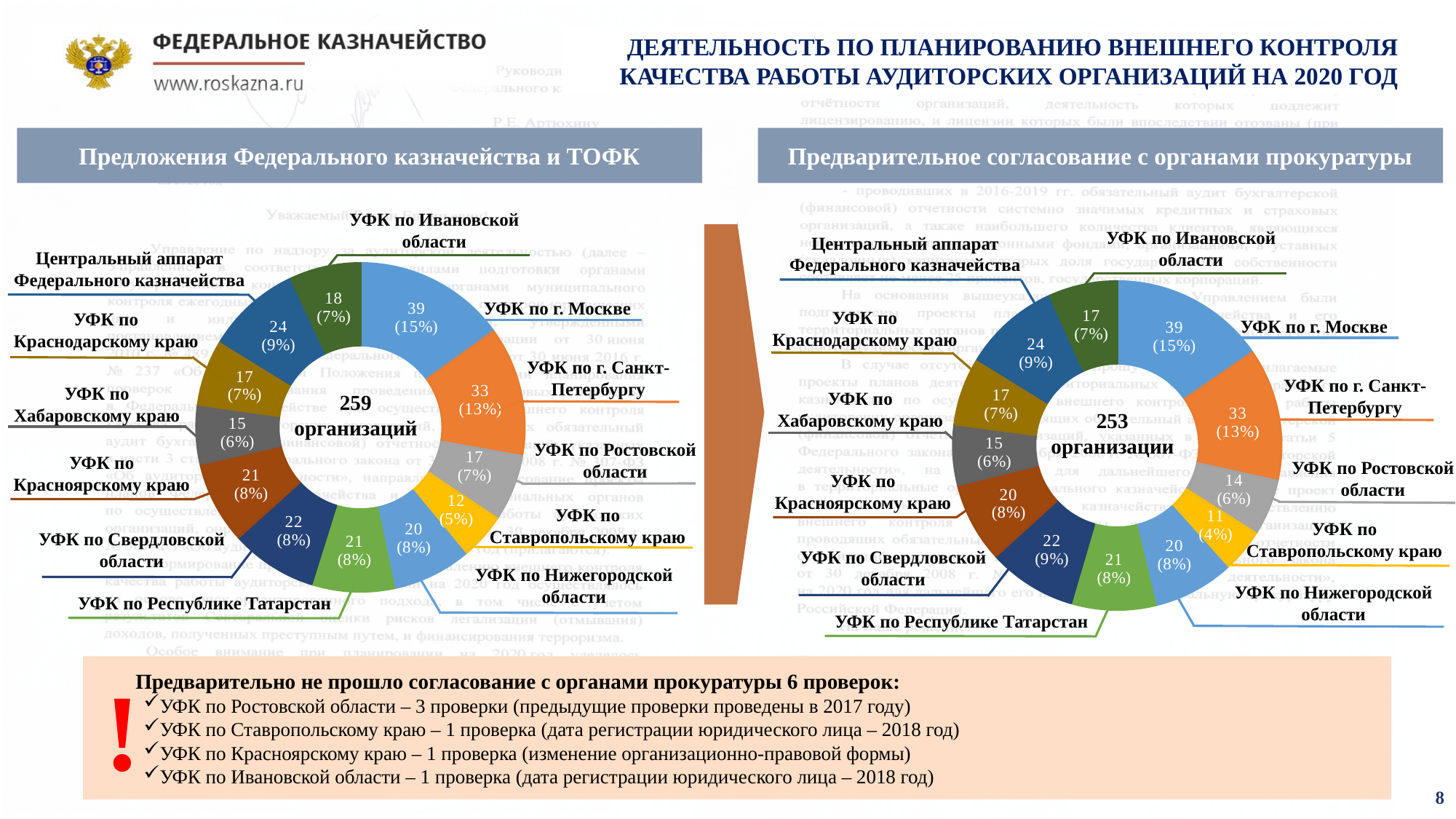
On the left chart (Предложения Федерального казначейства и ТОФК), what value is shown for УФК по г. Москве? 39 (15%) On the right chart (Предварительное согласование с органами прокуратуры), what value is shown for УФК по Ставропольскому краю? 11 (4%) What is the difference between the value for УФК по Ростовской области on the left chart and on the right chart? 3 On the right chart, which category has the smallest value? УФК по Ставропольскому краю On the left chart, what value is shown for УФК по Ивановской области? 18 (7%) What total number of organisations is shown in the centre of the right chart? 253 организации On the right chart, what value is shown for УФК по Ростовской области? 14 (6%) What type of chart is used on the left side of the slide? Donut (pie) chart On the left chart, which category has the largest value? УФК по г. Москве On the left chart, which is larger: УФК по Краснодарскому краю or УФК по Хабаровскому краю? УФК по Краснодарскому краю How many categories does the right chart show? 12 On the left chart, which category has the smallest value? УФК по Ставропольскому краю